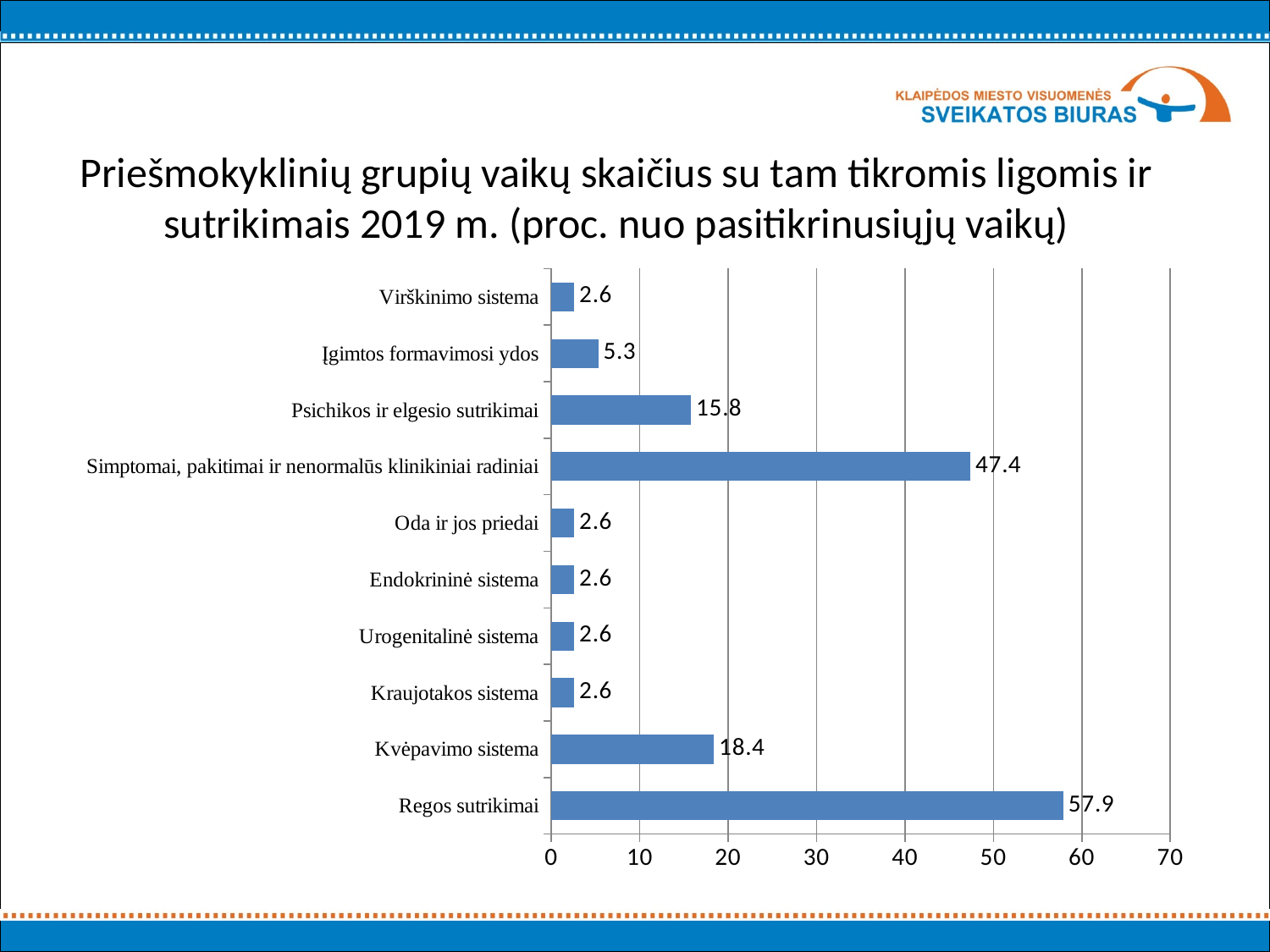
What is the value for Įgimtos formavimosi ydos? 5.3 What is the value for Simptomai, pakitimai ir nenormalūs klinikiniai radiniai? 47.4 What is the difference between the values for Regos sutrikimai and Simptomai, pakitimai ir nenormalūs klinikiniai radiniai? 10.5 What kind of chart is shown on the slide? bar chart How many categories have a value of 2.6? 5 How many categories are shown in the chart? 10 Which category has the highest value? Regos sutrikimai What is the value for Regos sutrikimai? 57.9 Is the value for Simptomai, pakitimai ir nenormalūs klinikiniai radiniai greater or less than 40? greater What is the value for Kvėpavimo sistema? 18.4 What is the value for Psichikos ir elgesio sutrikimai? 15.8 Which is larger, the value for Kvėpavimo sistema or the value for Psichikos ir elgesio sutrikimai? Kvėpavimo sistema